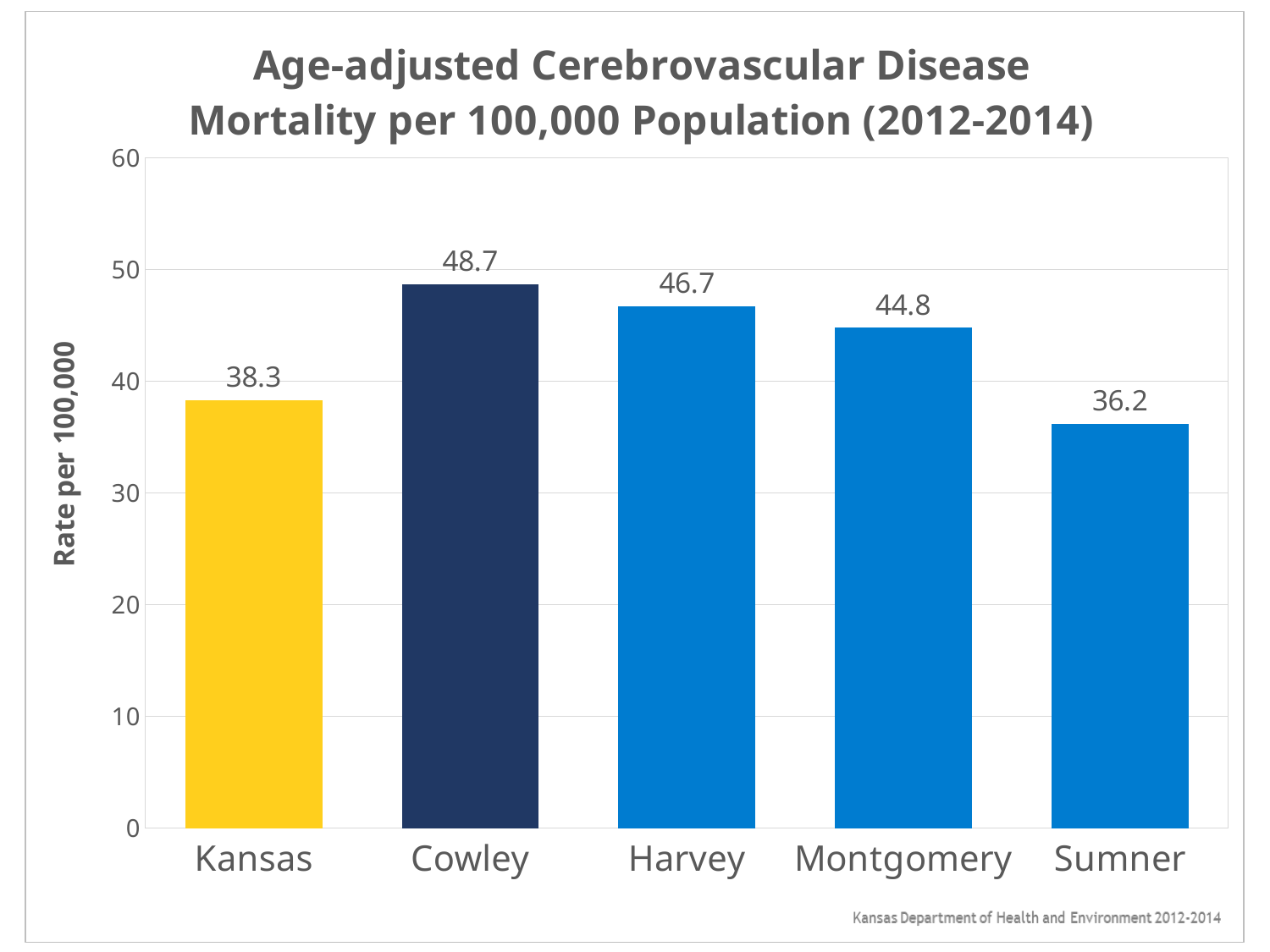
What is the age-adjusted cerebrovascular disease mortality rate for Cowley? 48.7 What is the difference between the rates for Cowley and Kansas? 10.4 What is the rate per 100,000 shown for Kansas? 38.3 Which category has the highest mortality rate? Cowley Which category has the lowest mortality rate? Sumner What is the value shown for Montgomery? 44.8 What is the label of the vertical axis? Rate per 100,000 Is the value for Sumner greater or less than 40? less What is the difference between the rates for Harvey and Sumner? 10.5 How many categories are shown on the x axis? 5 What kind of chart is shown on the slide? bar chart Which has a higher mortality rate, Harvey or Montgomery? Harvey